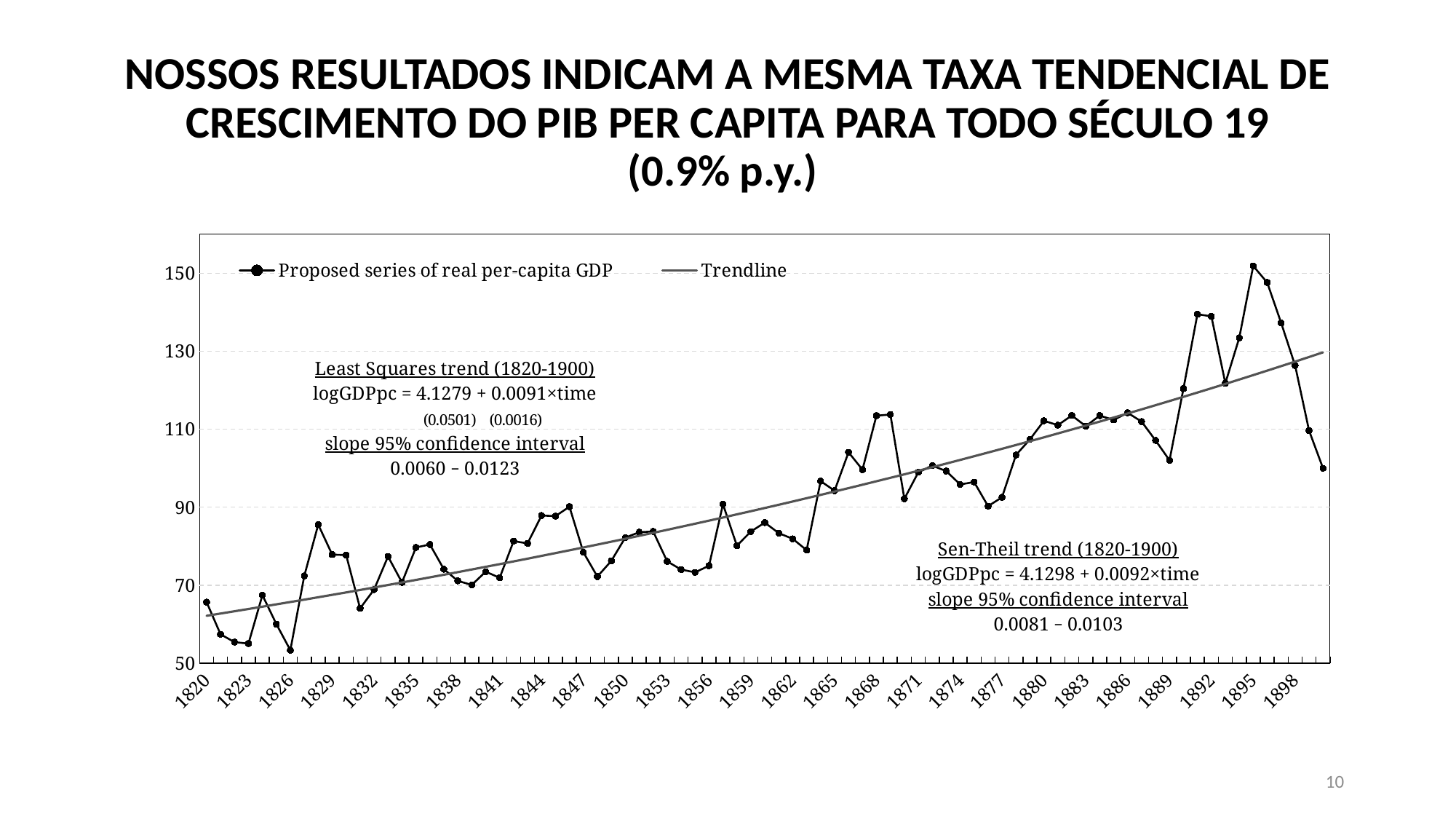
According to the annotation on the chart, what is the slope 95% confidence interval for the Sen-Theil trend (1820-1900)? 0.0081 – 0.0103 Is the value of the proposed series of real per-capita GDP in 1826 greater or less than 70? less Is the value of the Trendline in 1820 greater or less than 70? less Is the value of the proposed series of real per-capita GDP in 1868 greater or less than 90? greater Do the values of the proposed series of real per-capita GDP generally rise or fall from 1820 to 1900? rise In which year does the proposed series of real per-capita GDP reach its highest value? 1895 How many year labels are shown on the x axis? 27 What are the two entries in the chart legend? Proposed series of real per-capita GDP; Trendline Which year has the larger value of the proposed series of real per-capita GDP, 1868 or 1877? 1868 How many series does the legend list? 2 What kind of chart is shown on the slide? line chart